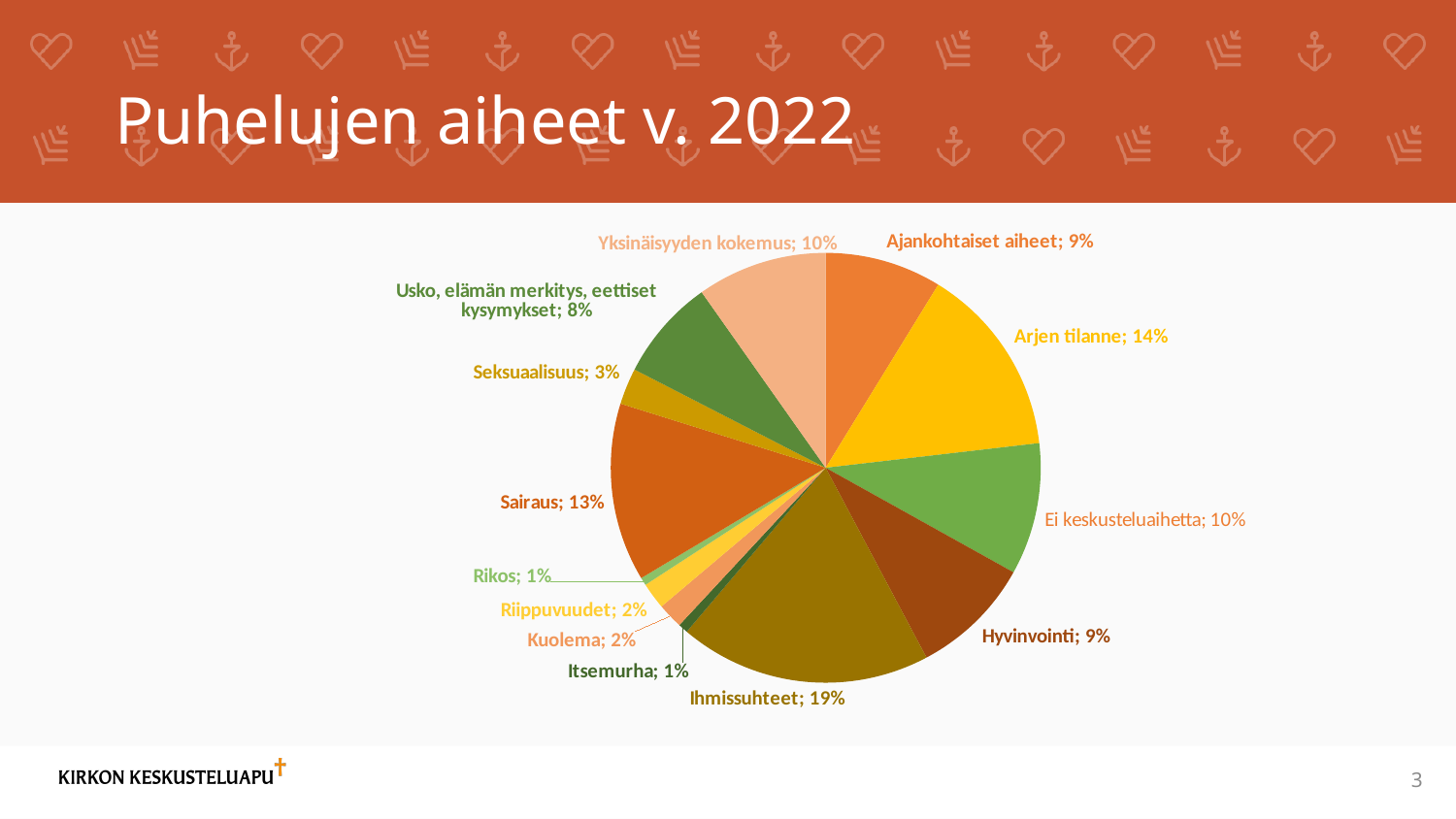
What is the difference in percentage points between Ihmissuhteet and Arjen tilanne? 5 What is the title of the slide containing the chart? Puhelujen aiheet v. 2022 Which has a larger share, Sairaus or Yksinäisyyden kokemus? Sairaus What share of the pie does Ei keskusteluaihetta have? 10% What share of the pie does Seksuaalisuus have? 3% What type of chart is shown on the slide? pie chart Which category has the largest share of the pie? Ihmissuhteet How many categories (slices) does the pie chart have? 13 What share of the pie does Ihmissuhteet have? 19% What share of the pie does Usko, elämän merkitys, eettiset kysymykset have? 8% What share of the pie does Arjen tilanne have? 14% What share of the pie does Sairaus have? 13%